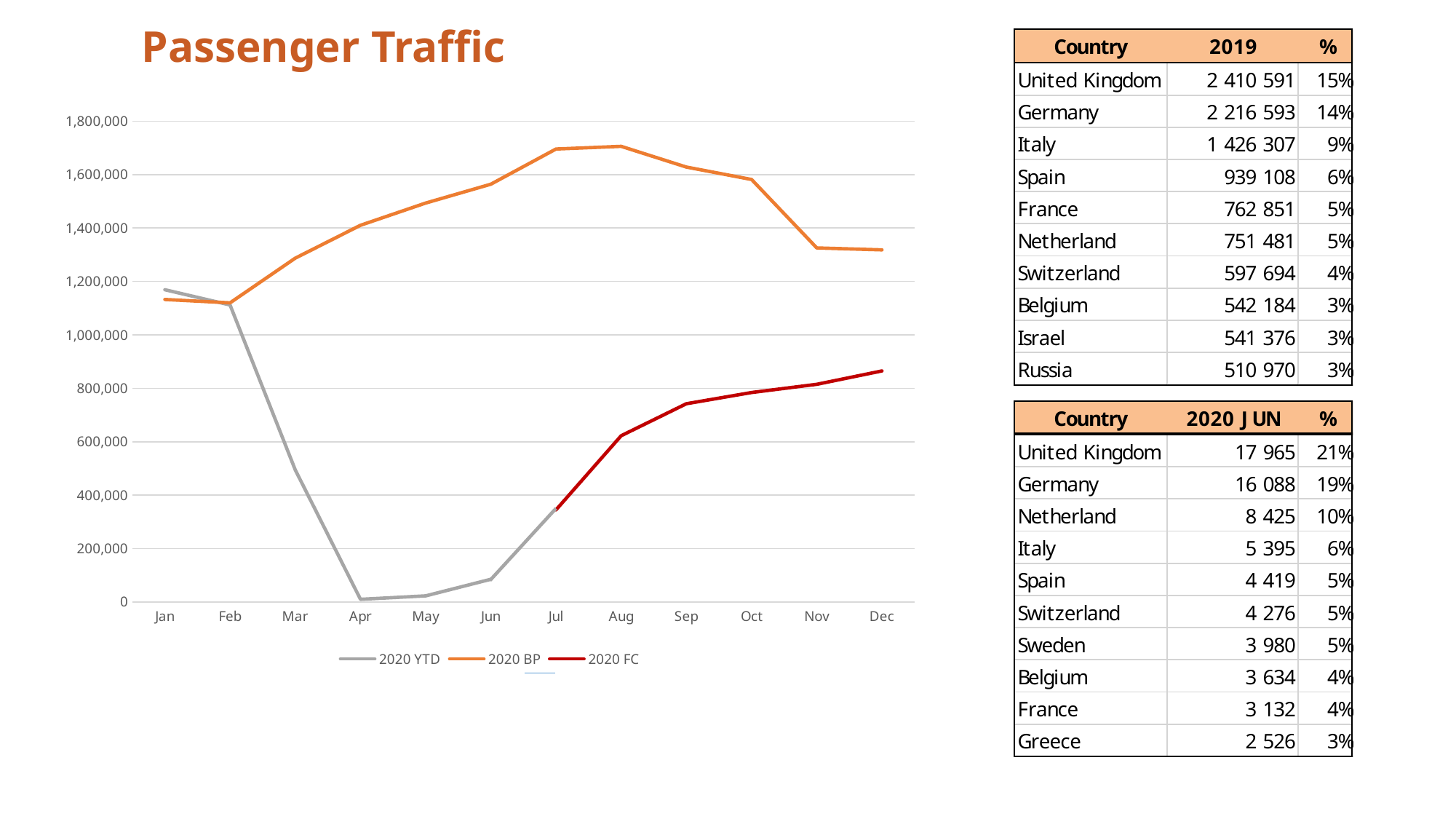
Is the value for 2020 FC in Dec greater or less than 800,000? greater Is the value for 2020 BP in Aug greater or less than 1,600,000? greater What kind of chart is shown on the slide? line chart What colour is the 2020 FC line in the chart? red How many months are shown along the x axis of the chart? 12 Is the value for 2020 YTD in Apr greater or less than 200,000? less Does the 2020 YTD line rise or fall from Feb to Apr? fall Which is larger, the 2020 BP value in Oct or the 2020 BP value in Nov? Oct How many series does the chart legend list? 3 Does the 2020 FC line rise or fall from Jul to Dec? rise What are the three series named in the chart legend? 2020 YTD, 2020 BP, 2020 FC